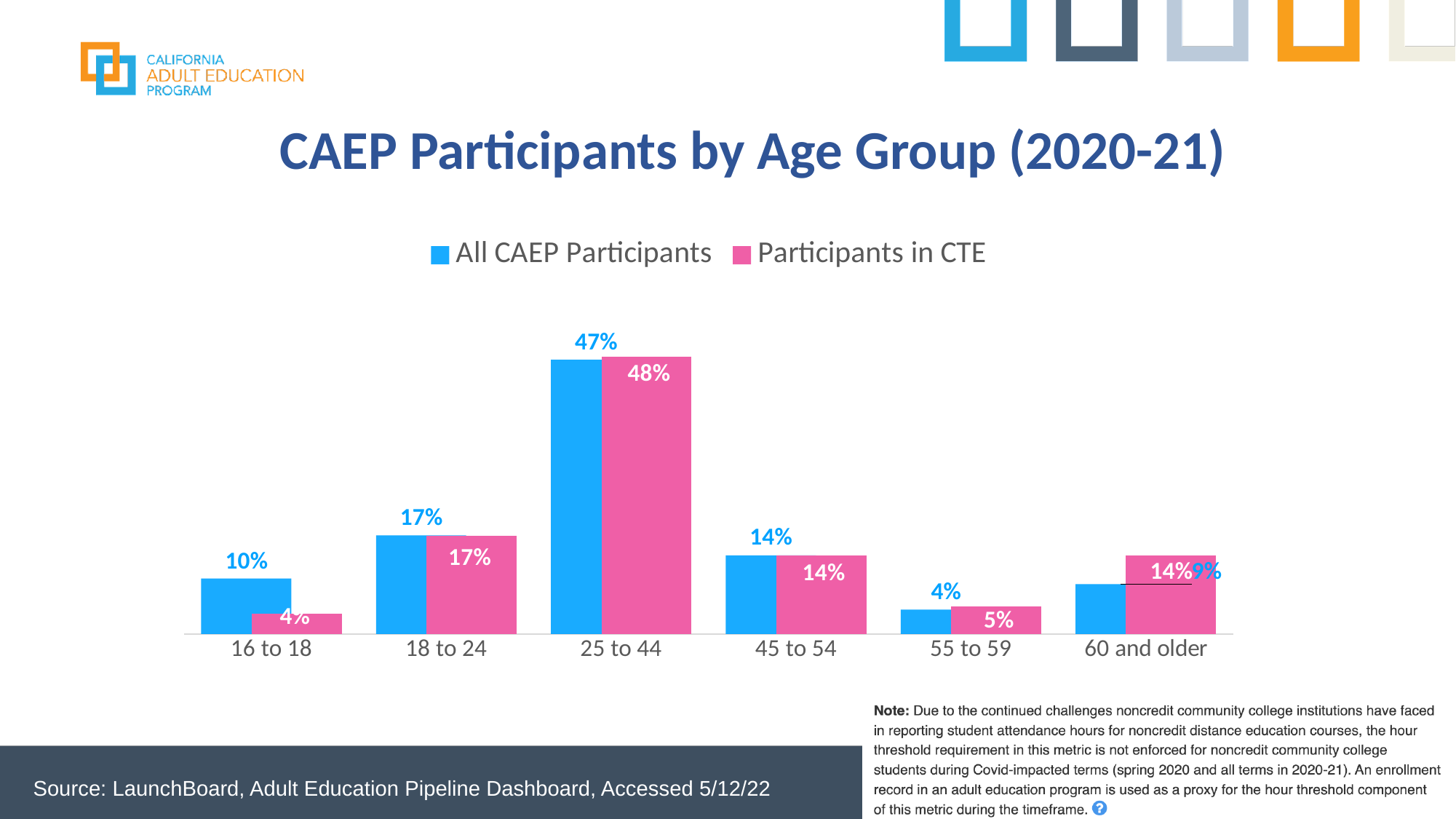
What colour represents Participants in CTE in the chart? Pink What type of chart is shown on the slide? Bar chart What is the value for Participants in CTE in the 55 to 59 age group? 5% What is the difference between All CAEP Participants and Participants in CTE in the 16 to 18 age group? 6% Which age group has the highest share of All CAEP Participants? 25 to 44 In the 55 to 59 age group, which series has the larger value: All CAEP Participants or Participants in CTE? Participants in CTE What is the value for All CAEP Participants in the 18 to 24 age group? 17% What percentage of All CAEP Participants are in the 25 to 44 age group? 47% How many age groups are shown on the x axis? 6 How many series does the legend list? 2 What percentage of Participants in CTE are in the 16 to 18 age group? 4% Which age group has the lowest share of Participants in CTE? 16 to 18